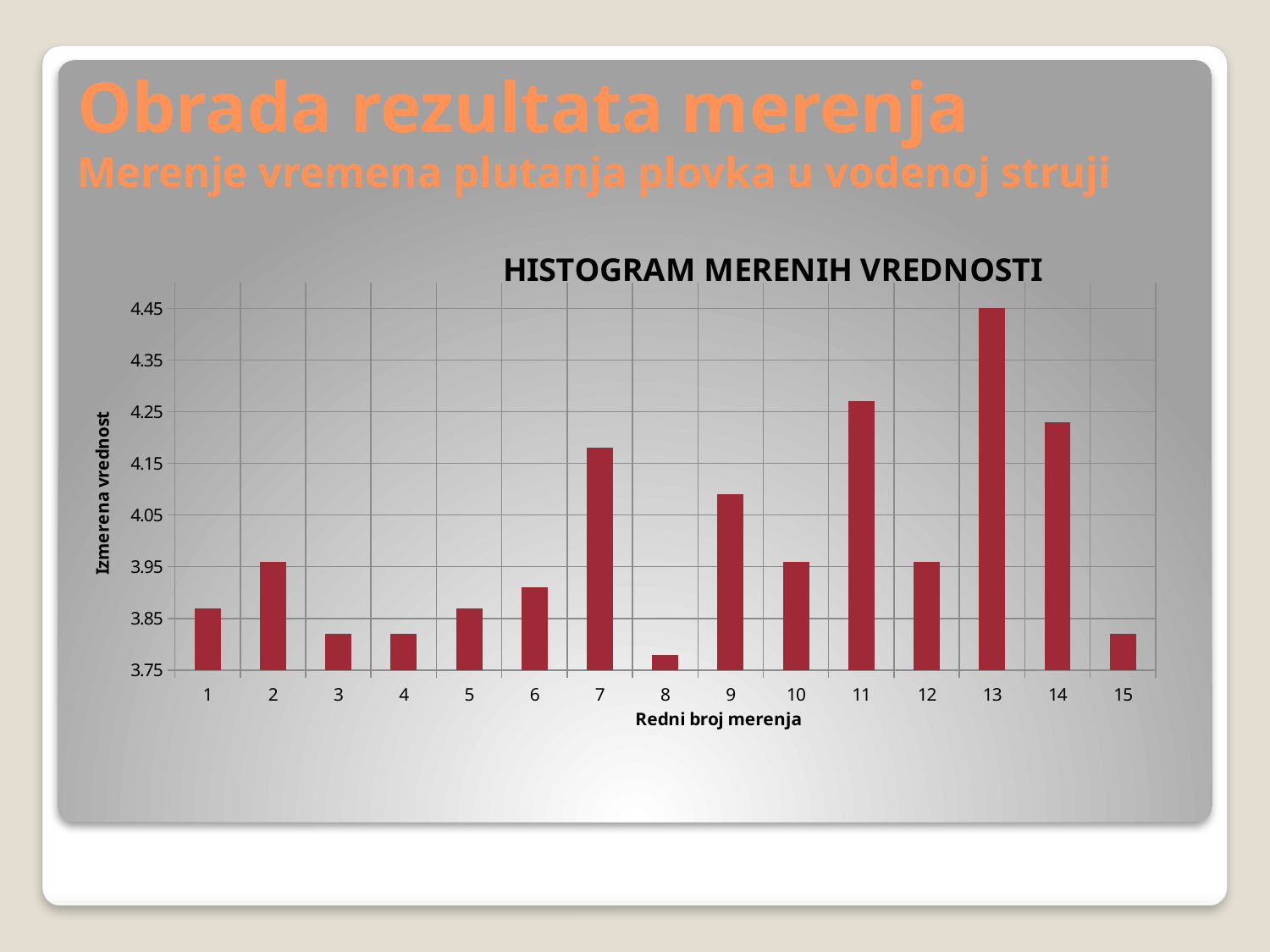
Which measurement number has the highest value? 13 What is the title of the chart? HISTOGRAM MERENIH VREDNOSTI Is the value for measurement 8 greater or less than 3.85? less Which has the larger value, measurement 7 or measurement 9? 7 Is the value for measurement 7 greater or less than 4.15? greater How many measurements (bars) are plotted in the chart? 15 Which measurement number has the lowest value? 8 What is the label of the x axis? Redni broj merenja What kind of chart is shown on the slide? bar chart Is the value for measurement 14 greater or less than 4.25? less What is the value for measurement 13? 4.45